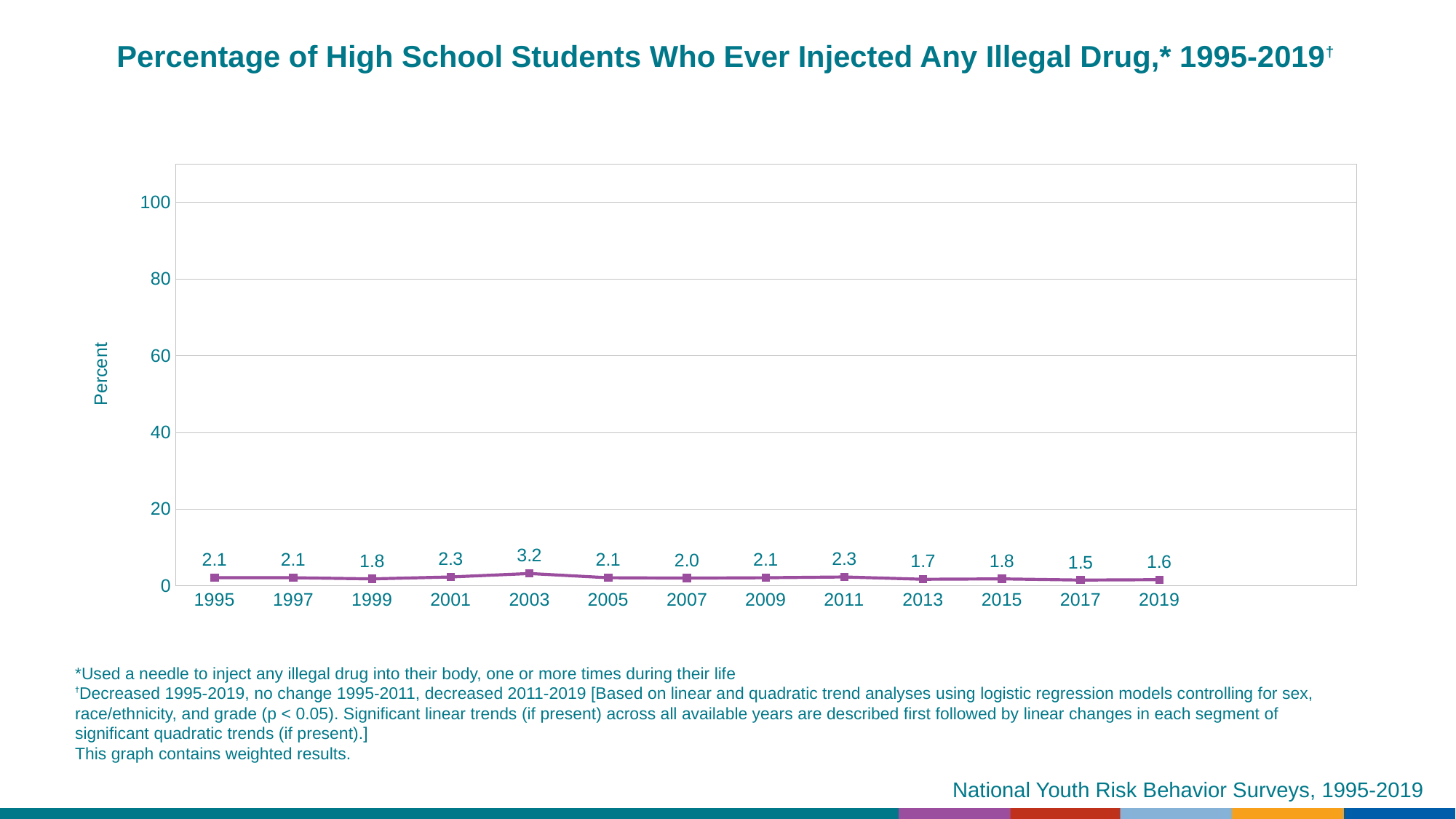
Which year has a larger value, 2011 or 2013? 2011 What is the value shown for 1995? 2.1 What is the difference between the 2003 value and the 2019 value? 1.6 How many years are plotted on the chart? 13 Which year has the lowest percentage? 2017 What is the label on the y axis? Percent What is the value shown for 2019? 1.6 What kind of chart is shown on the slide? line chart Does the value rise or fall from 2011 to 2019? fall Which year has the highest percentage? 2003 Is the value for 2003 greater or less than 20? less What percentage of high school students had ever injected any illegal drug in 2003? 3.2